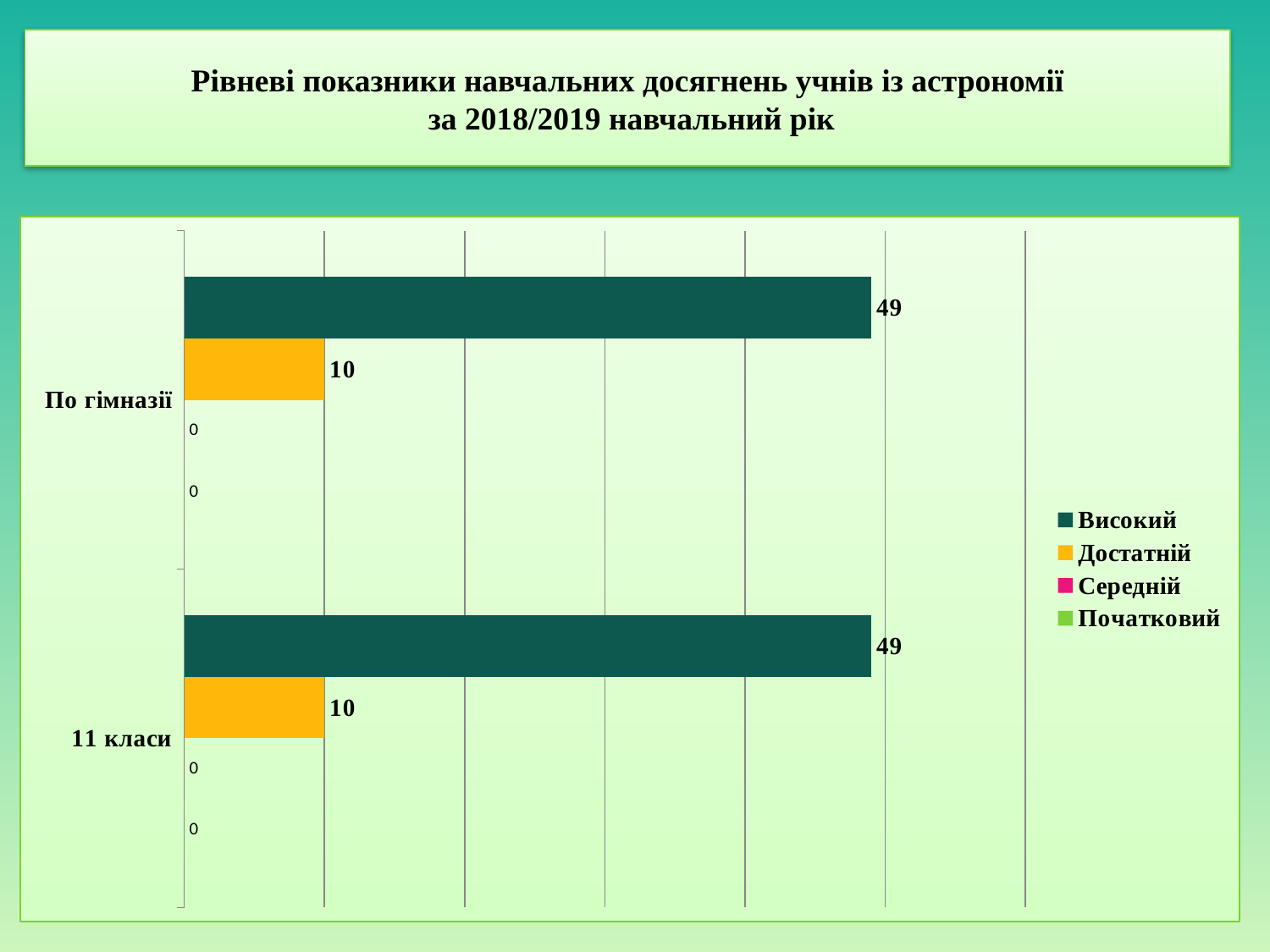
What is the value for Початковий in the 11 класи category? 0 What is the difference between the Високий and Достатній values for По гімназії? 39 Which series has the highest value in the 11 класи category? Високий How many categories are shown on the vertical axis of the chart? 2 What kind of chart is shown on the slide? bar chart How many series does the legend list? 4 Which legend entry is shown in orange? Достатній What is the value for Середній in the По гімназії category? 0 Which is larger for 11 класи: the Високий value or the Достатній value? Високий What is the value for Достатній in the 11 класи category? 10 What is the value for Високий in the По гімназії category? 49 What is the total of the four series values for the 11 класи category? 59